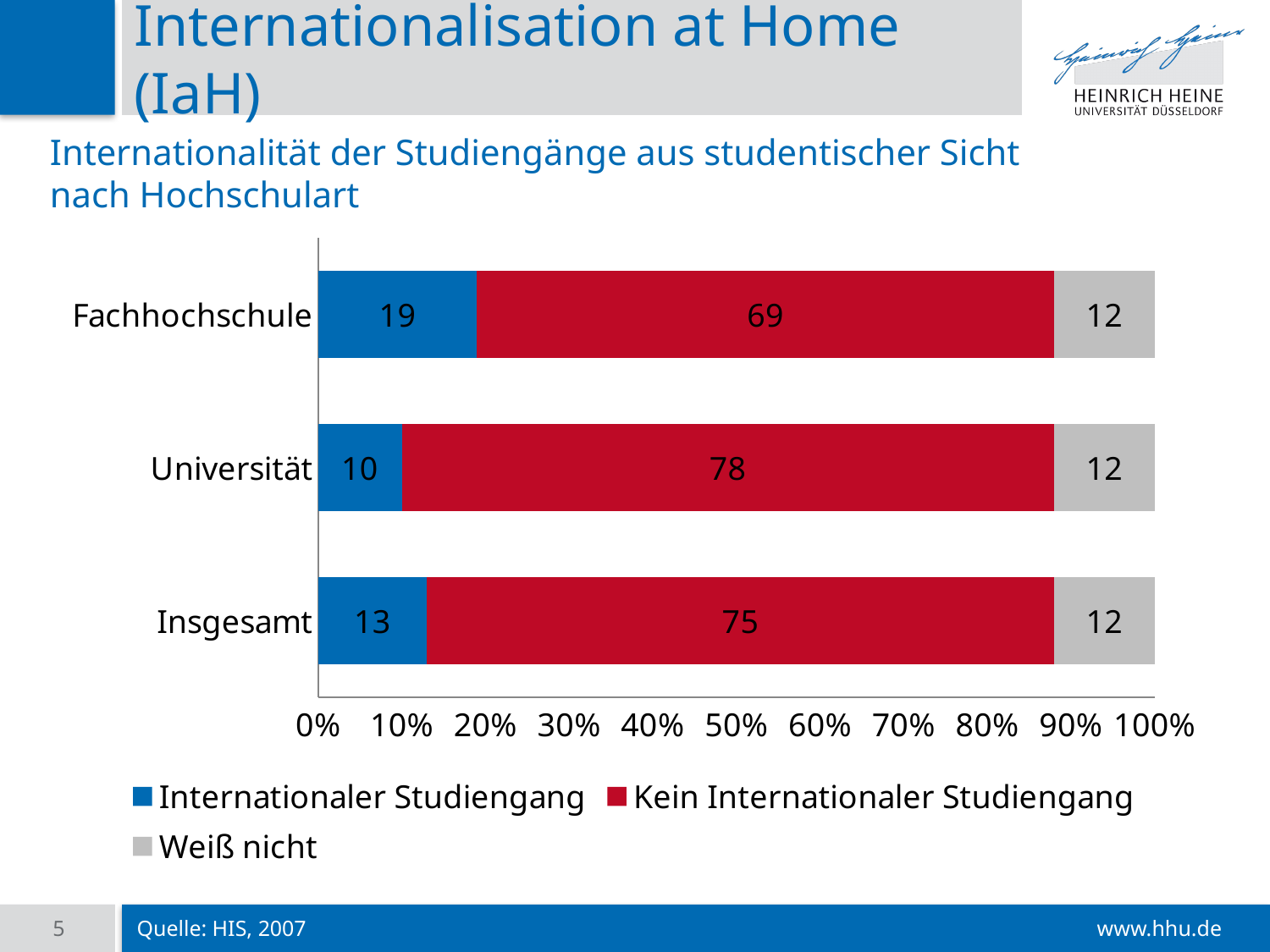
Which is larger, the Internationaler Studiengang value for Universität or for Insgesamt? Insgesamt Which category has the highest value for Internationaler Studiengang? Fachhochschule What is the value for Internationaler Studiengang for Fachhochschule? 19 What kind of chart is shown on the slide? Stacked bar chart What is the value for Weiß nicht for Insgesamt? 12 How many series does the legend list? 3 What is the total of the stacked bar for Fachhochschule? 100 Which colour represents Weiß nicht in the legend? Grey What is the value for Kein Internationaler Studiengang for Universität? 78 Which category has the lowest value for Kein Internationaler Studiengang? Fachhochschule What is the difference between the Kein Internationaler Studiengang values for Universität and Fachhochschule? 9 How many categories are shown on the y axis? 3